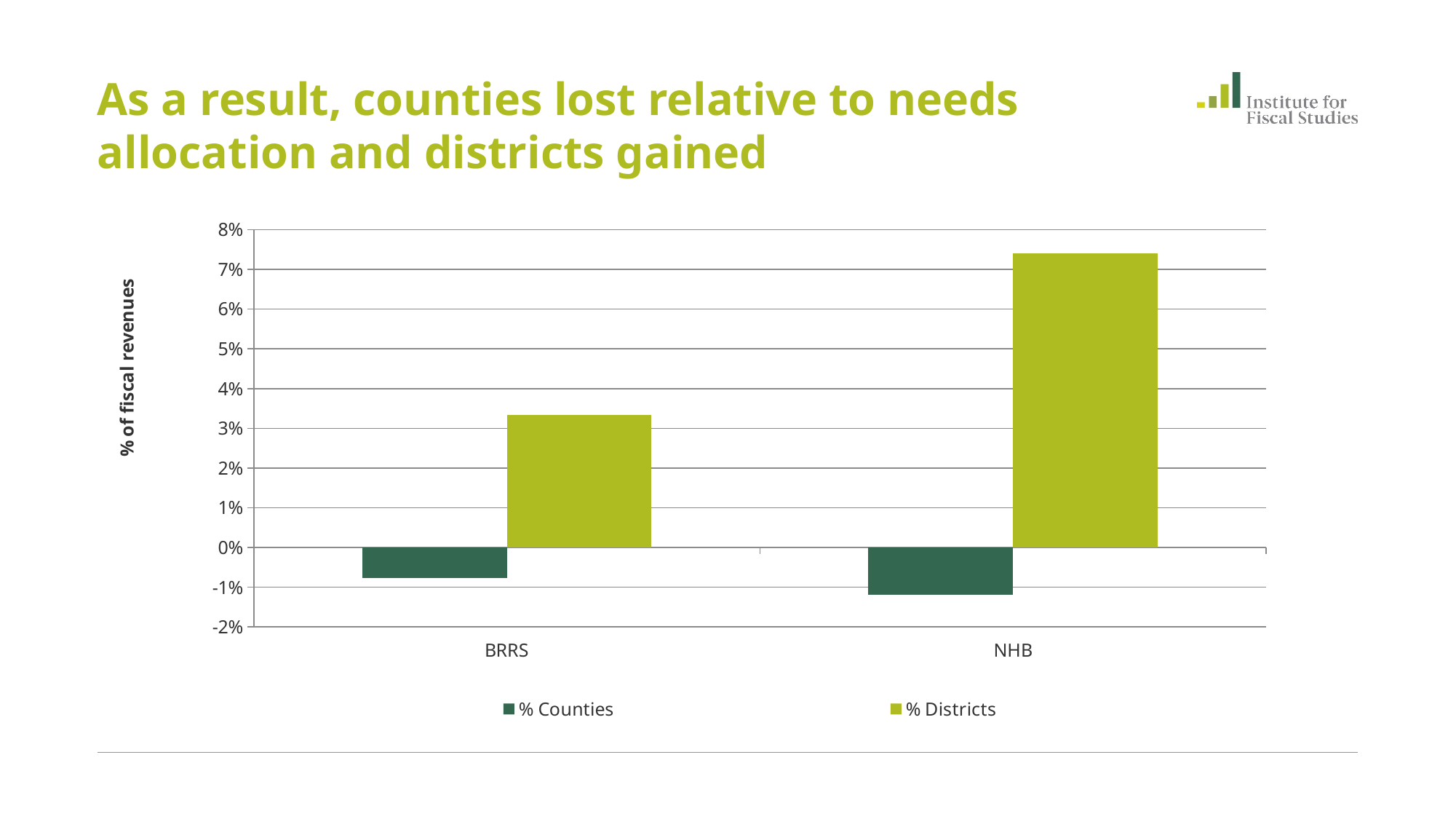
Which category has the higher % Counties value, BRRS or NHB? BRRS Is the % Counties value for BRRS greater or less than 0%? less Is the % Counties value for NHB greater or less than -1%? less How many series does the legend list? 2 Which category and series has the lowest bar? % Counties for NHB Which category and series has the highest bar? % Districts for NHB How many categories are shown on the x axis? 2 What is the label on the vertical axis? % of fiscal revenues Is the % Districts value for BRRS greater or less than 3%? greater Which category has the larger % Districts value, BRRS or NHB? NHB What kind of chart is shown on the slide? bar chart